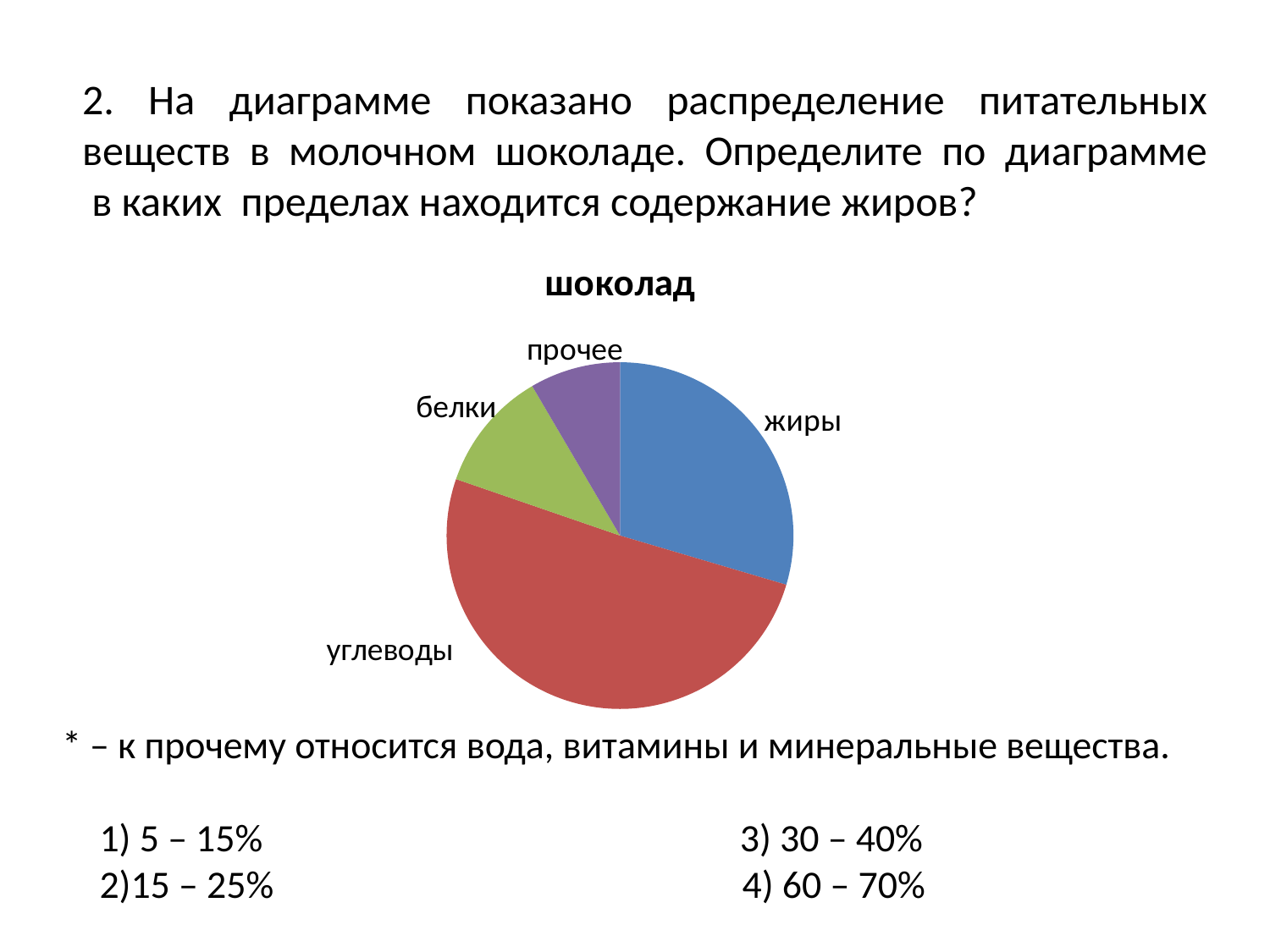
Which slice is larger, жиры or прочее? жиры What kind of chart is shown on the slide? pie chart Which slice is larger, прочее or углеводы? углеводы What colour is the жиры slice in the pie chart? blue Which slice is larger, углеводы or жиры? углеводы Which category has the largest slice in the pie chart? углеводы What is the title of the pie chart? шоколад How many slices does the pie chart have? 4